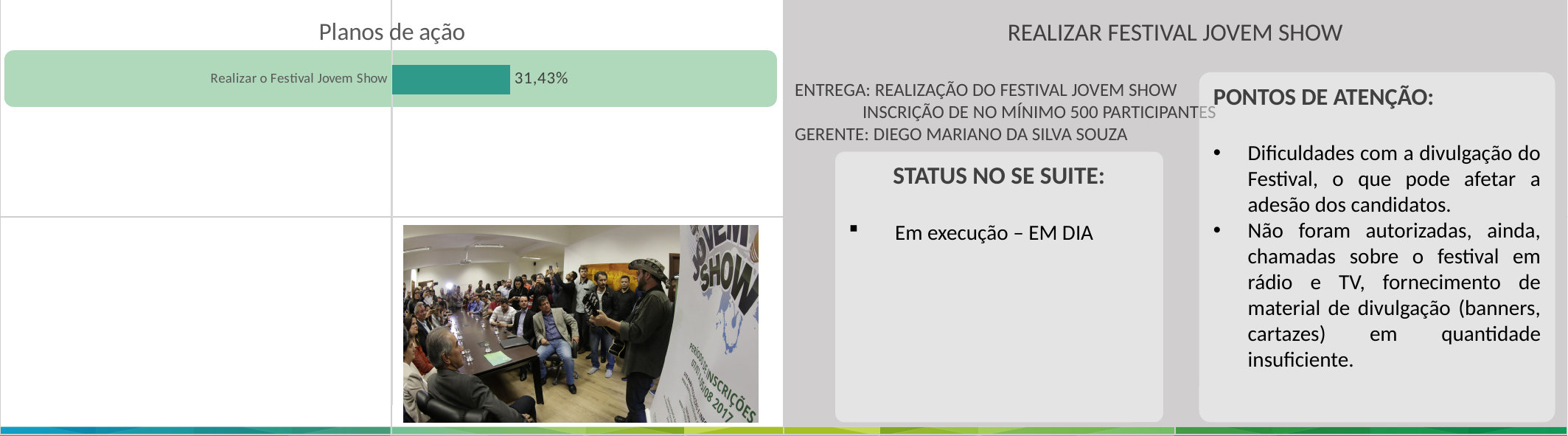
Are the bars in the "Planos de ação" chart horizontal or vertical? horizontal Is the value for "Realizar o Festival Jovem Show" in the "Planos de ação" chart greater or less than 30%? greater Is the value for "Realizar o Festival Jovem Show" in the "Planos de ação" chart greater or less than 50%? less What is the value shown for "Realizar o Festival Jovem Show" in the "Planos de ação" chart? 31,43% What is the title of the chart on the slide? Planos de ação What kind of chart is shown under the title "Planos de ação"? bar chart What is the label of the only category in the "Planos de ação" chart? Realizar o Festival Jovem Show How many categories are plotted in the "Planos de ação" chart? 1